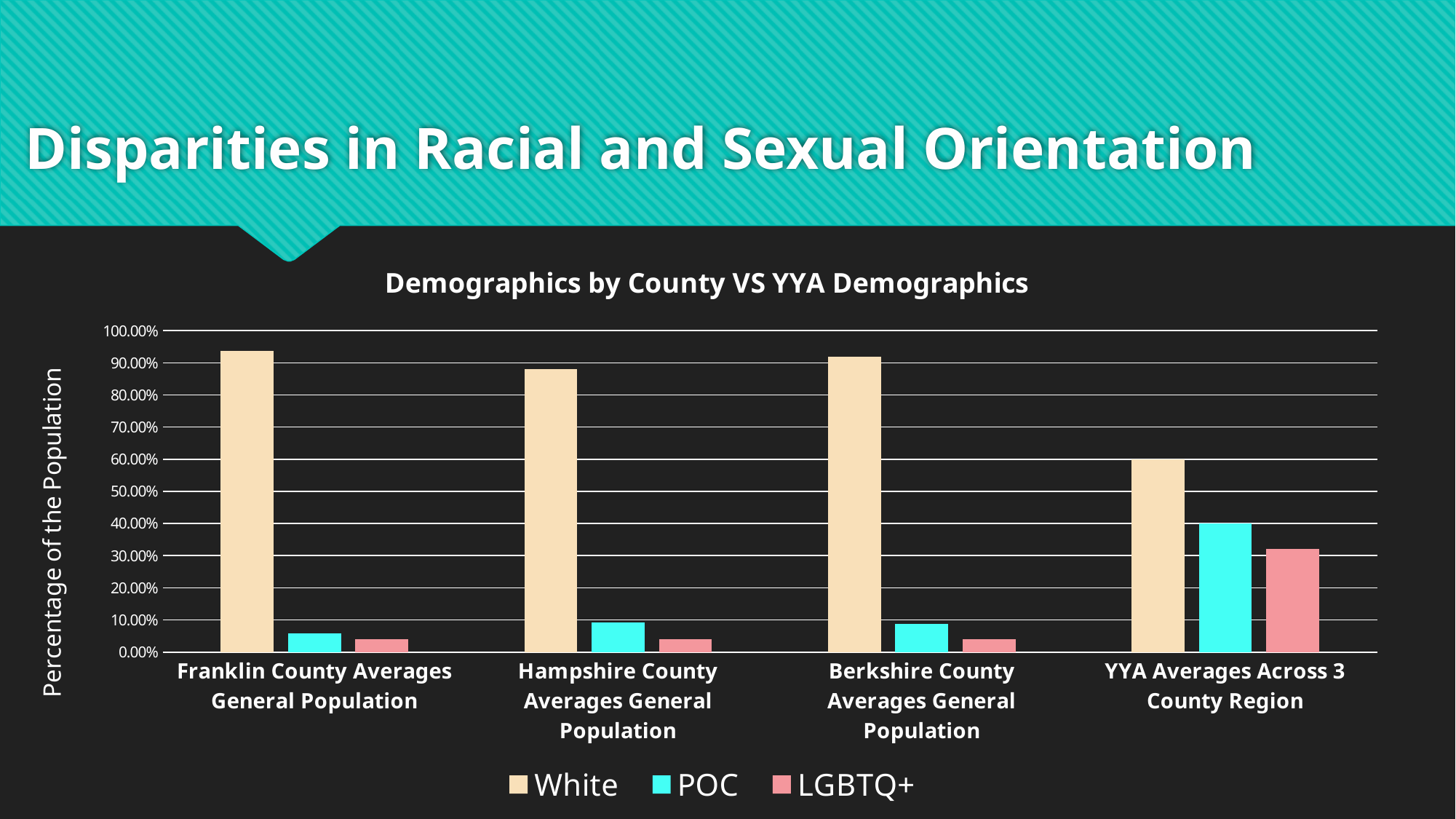
Which category has the highest POC value? YYA Averages Across 3 County Region Is the POC value for Franklin County Averages General Population greater or less than 10.00%? less How many series does the legend list? 3 Is the White value for Hampshire County Averages General Population greater or less than 80.00%? greater What is the label of the y axis? Percentage of the Population Which is larger for YYA Averages Across 3 County Region, the POC value or the LGBTQ+ value? POC What kind of chart is shown on the slide? bar chart How many categories are shown along the x axis? 4 What is the title of the chart? Demographics by County VS YYA Demographics Which category has the lowest White value? YYA Averages Across 3 County Region Which category has the highest White value? Franklin County Averages General Population Is the LGBTQ+ value for YYA Averages Across 3 County Region greater or less than 30.00%? greater